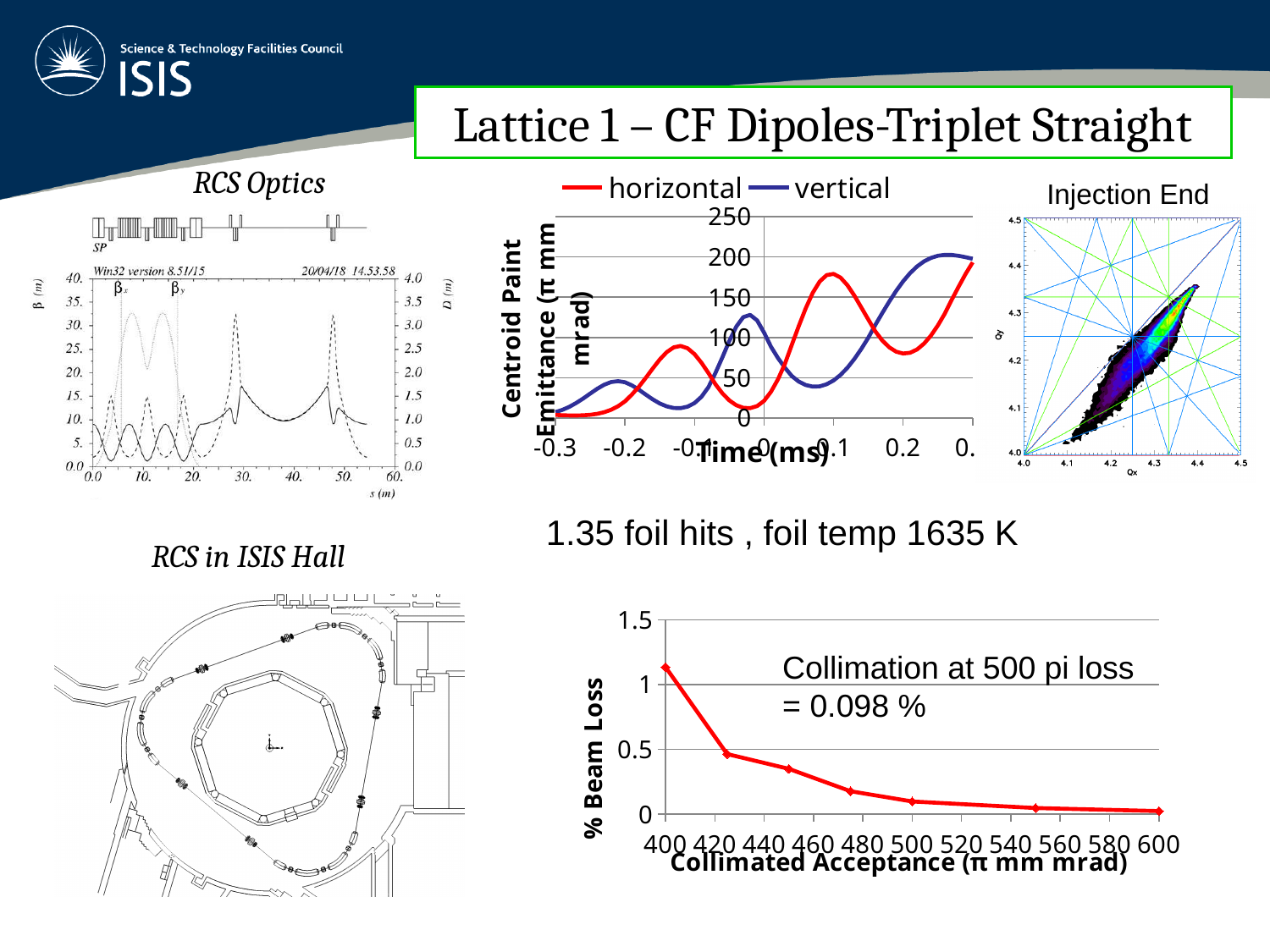
What kind of chart is the % Beam Loss chart at the bottom right of the slide? line chart What kind of chart is the Centroid Paint Emittance chart at the top of the slide? line chart In the Centroid Paint Emittance chart, which series has the larger value at 0.2 ms, horizontal or vertical? vertical In the Centroid Paint Emittance chart, is the horizontal value at 0.1 ms greater or less than 150? greater In the Centroid Paint Emittance chart, is the vertical value at -0.1 ms greater or less than 50? less In the % Beam Loss chart, is the beam loss at 400 π mm mrad greater or less than 1? greater What are the two series named in the legend of the Centroid Paint Emittance chart? horizontal and vertical In the % Beam Loss chart, what is the beam loss at a collimated acceptance of 500 π mm mrad? 0.098 % In the % Beam Loss chart, does beam loss rise or fall as collimated acceptance increases from 400 to 600? fall In the Centroid Paint Emittance chart, which series has the larger value at 0.1 ms, horizontal or vertical? horizontal In the % Beam Loss chart, at which collimated acceptance is the beam loss highest? 400 How many series does the legend of the Centroid Paint Emittance chart list? 2